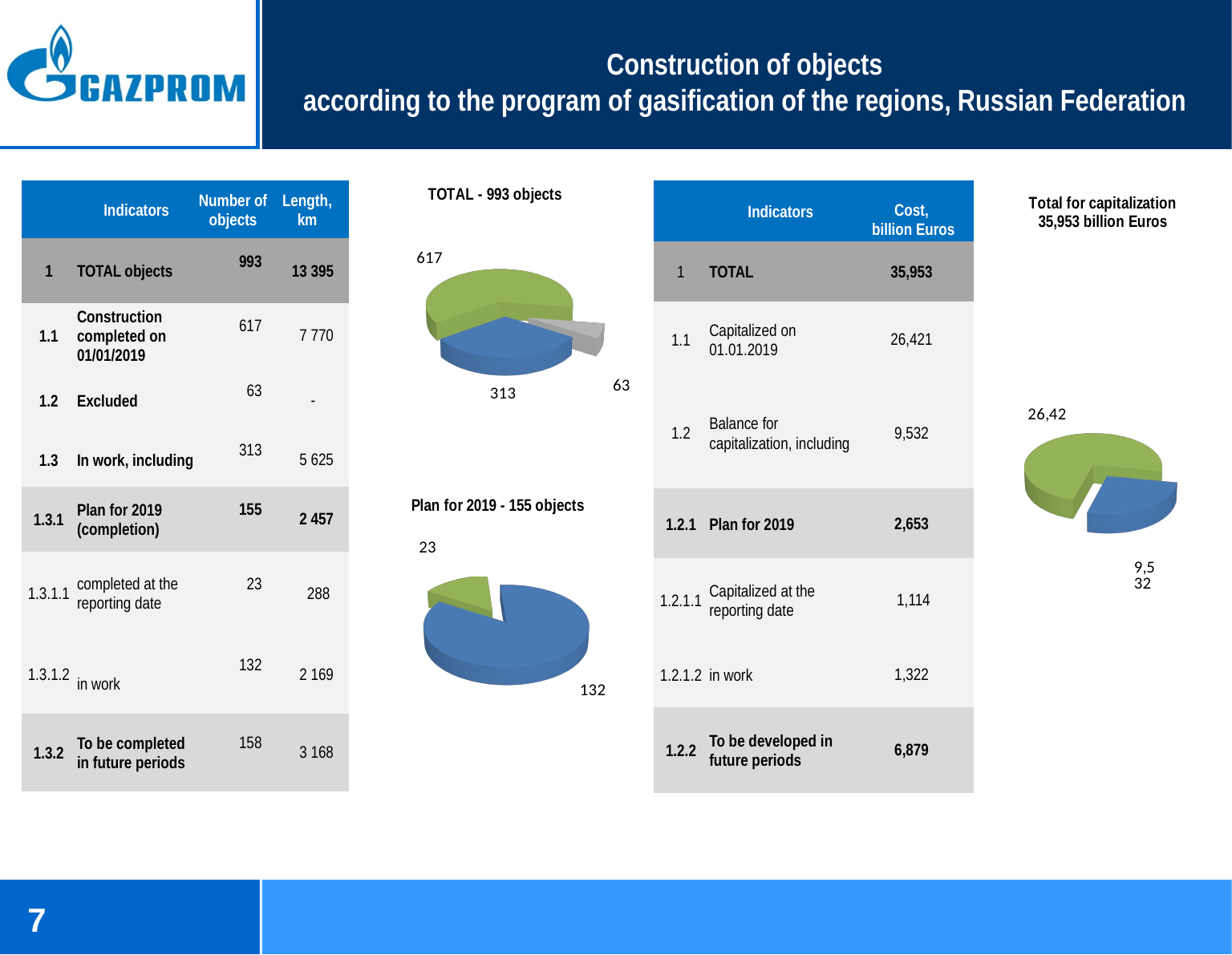
In the 'TOTAL - 993 objects' pie chart, what colour is the largest slice? green In the 'TOTAL - 993 objects' pie chart, what is the difference between the 617 slice and the 313 slice? 304 In the 'TOTAL - 993 objects' pie chart, what is the value of the smallest slice? 63 What kind of chart is the 'TOTAL - 993 objects' chart? pie chart In the 'TOTAL - 993 objects' pie chart, what is the total of the three slice values? 993 In the 'Total for capitalization 35,953 billion Euros' pie chart, what value is printed next to the green slice? 26,42 In the 'Plan for 2019 - 155 objects' pie chart, which slice is larger, the blue one or the green one? blue In the 'TOTAL - 993 objects' pie chart, what is the value of the largest slice? 617 How many slices does the 'Plan for 2019 - 155 objects' pie chart have? 2 How many slices does the 'TOTAL - 993 objects' pie chart have? 3 In the 'Plan for 2019 - 155 objects' pie chart, what is the value of the green slice? 23 In the 'Plan for 2019 - 155 objects' pie chart, what share of the total does the 132 slice represent? 85.2%